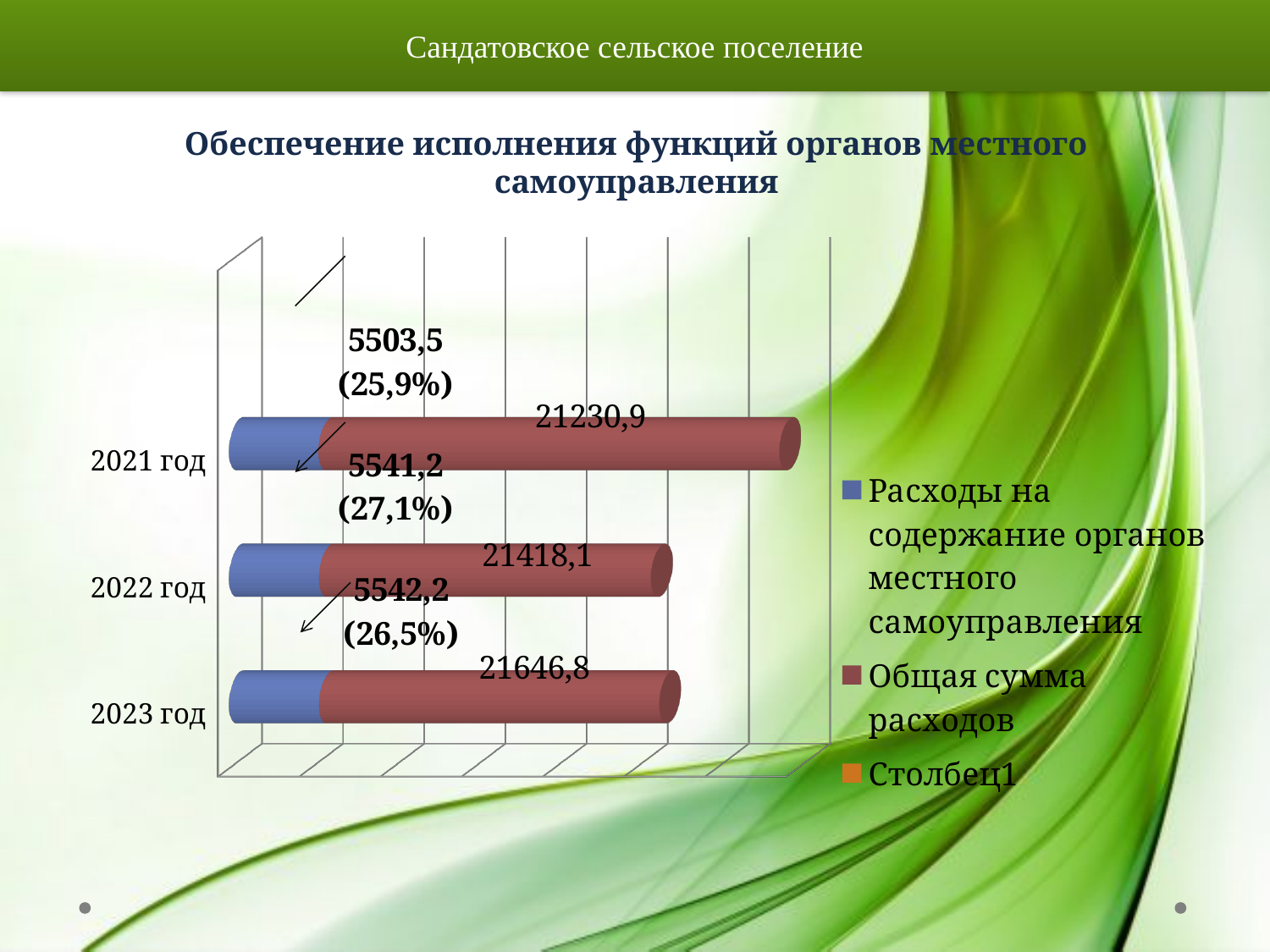
What is the value of "Общая сумма расходов" for 2021 год? 21230,9 Does the value of "Общая сумма расходов" rise or fall from 2021 год to 2023 год? rise What is the difference between the "Общая сумма расходов" values for 2023 год and 2021 год? 415,9 What is the value of "Общая сумма расходов" for 2023 год? 21646,8 What type of chart is shown on the slide? bar chart Which year has the lowest value of "Общая сумма расходов"? 2021 год Which year has the highest value of "Общая сумма расходов"? 2023 год How many year categories are plotted on the chart? 3 What is the value of "Общая сумма расходов" for 2022 год? 21418,1 What is the title of the chart? Обеспечение исполнения функций органов местного самоуправления What is the difference between the "Общая сумма расходов" values for 2023 год and 2022 год? 228,7 How many entries does the chart legend list? 3